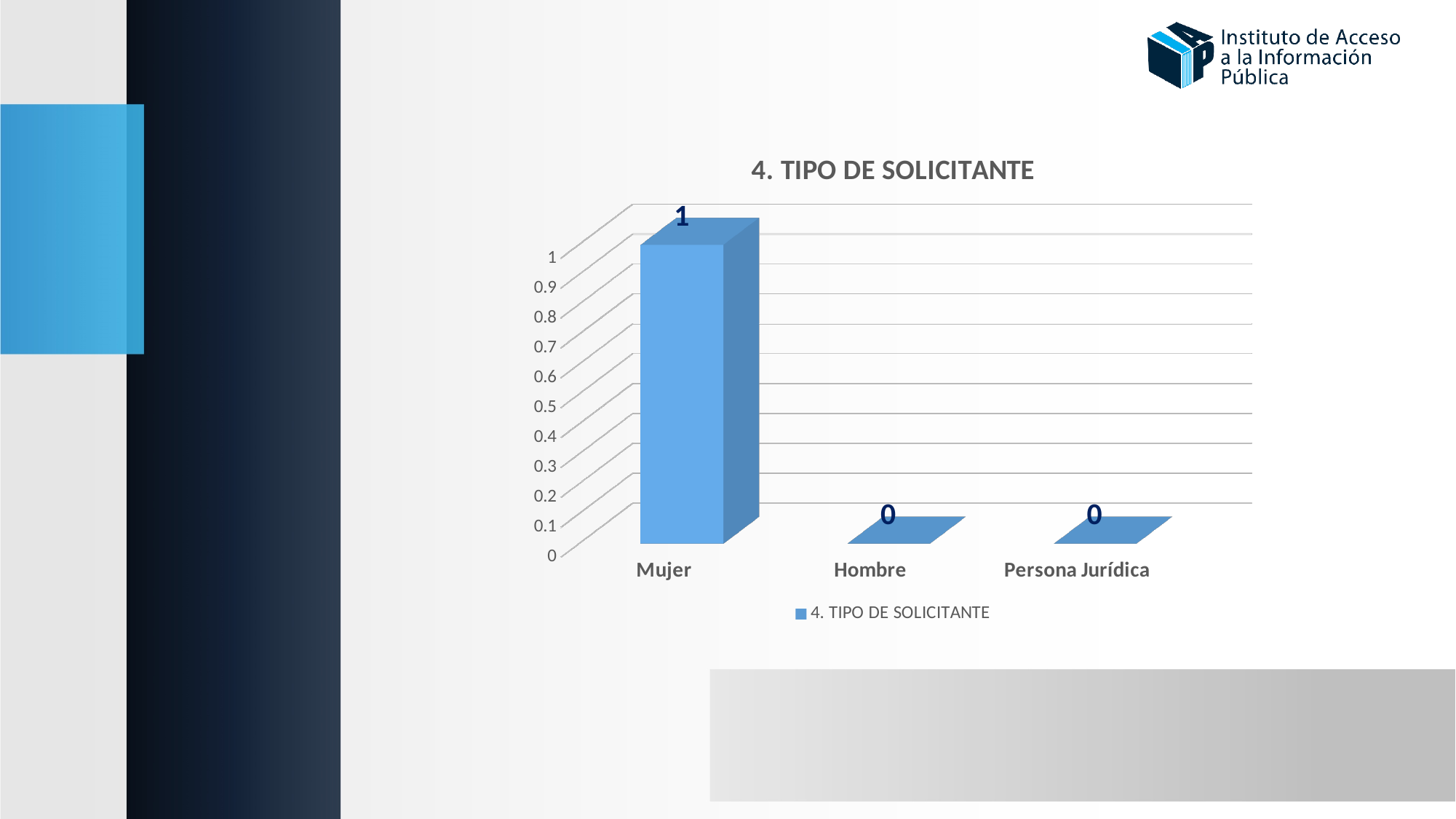
How many categories are shown on the x axis? 3 What is the value for Hombre? 0 What is the total of the values for Mujer, Hombre and Persona Jurídica? 1 Which category has the highest value? Mujer What is the value for Persona Jurídica? 0 What is the value for Mujer? 1 What is the title of the chart? 4. TIPO DE SOLICITANTE What is the difference between the values for Mujer and Hombre? 1 Which is larger, the value for Mujer or the value for Persona Jurídica? Mujer How many series does the legend list? 1 What kind of chart is shown? bar chart Is the value for Mujer greater or less than 0.5? greater